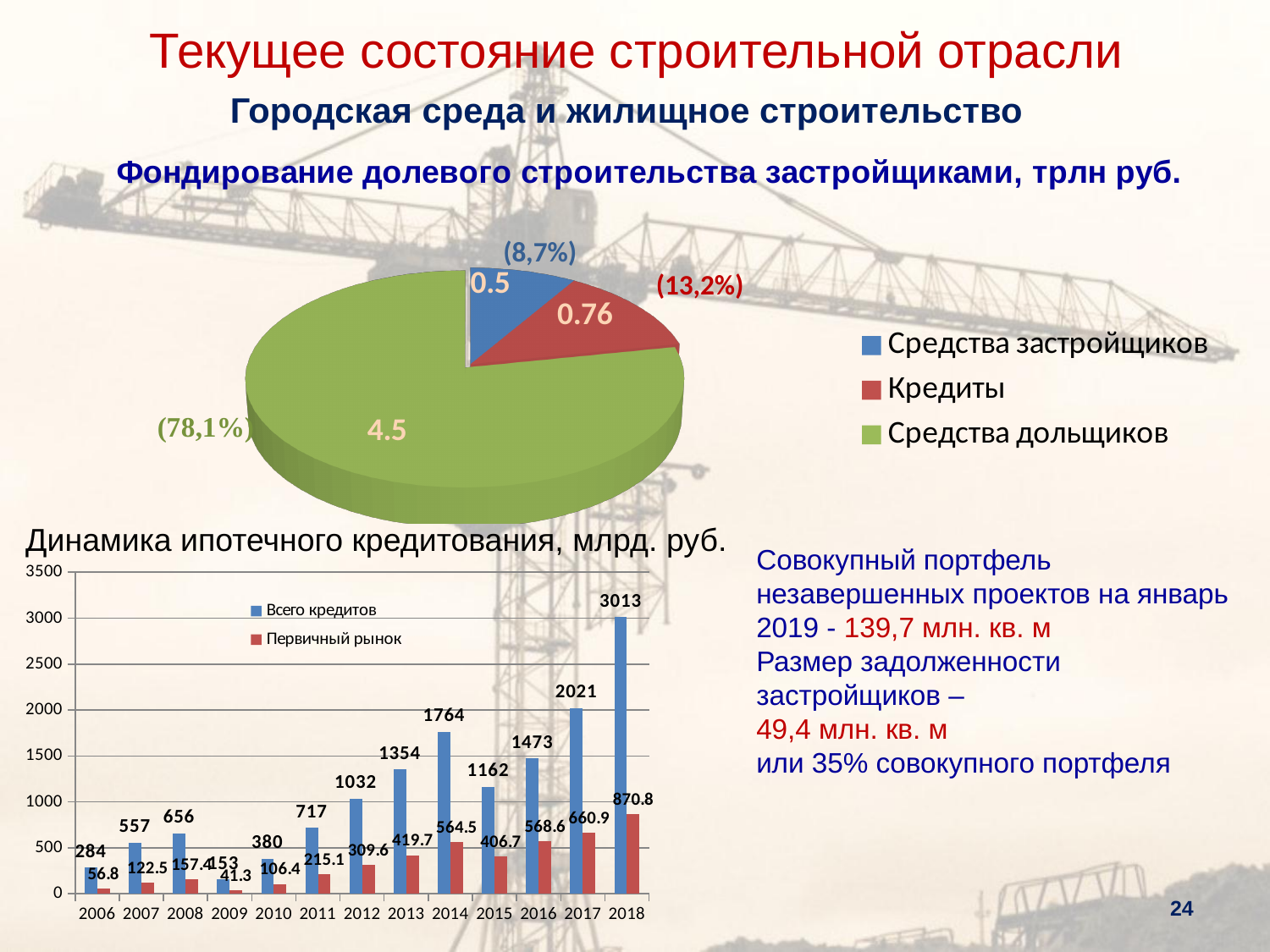
In the bar chart 'Динамика ипотечного кредитования', what is the difference between Всего кредитов in 2017 and 2016? 548 How many years are shown on the x axis of the bar chart 'Динамика ипотечного кредитования'? 13 In the bar chart 'Динамика ипотечного кредитования', what is the value of Всего кредитов for 2018? 3013 In the pie chart 'Фондирование долевого строительства застройщиками', what share does Кредиты have? 13,2% In the bar chart 'Динамика ипотечного кредитования', which is larger: Всего кредитов in 2014 or in 2015? 2014 In the pie chart 'Фондирование долевого строительства застройщиками', which category has the smallest slice? Средства застройщиков In the bar chart 'Динамика ипотечного кредитования', what colour are the Первичный рынок bars? Red How many categories does the legend of the pie chart 'Фондирование долевого строительства застройщиками' list? 3 In the pie chart 'Фондирование долевого строительства застройщиками', what is the value for Средства дольщиков? 4.5 In the bar chart 'Динамика ипотечного кредитования', which year has the lowest value of Всего кредитов? 2009 In the bar chart 'Динамика ипотечного кредитования', what is the value of Первичный рынок for 2014? 564.5 What type of chart is 'Динамика ипотечного кредитования'? Bar chart